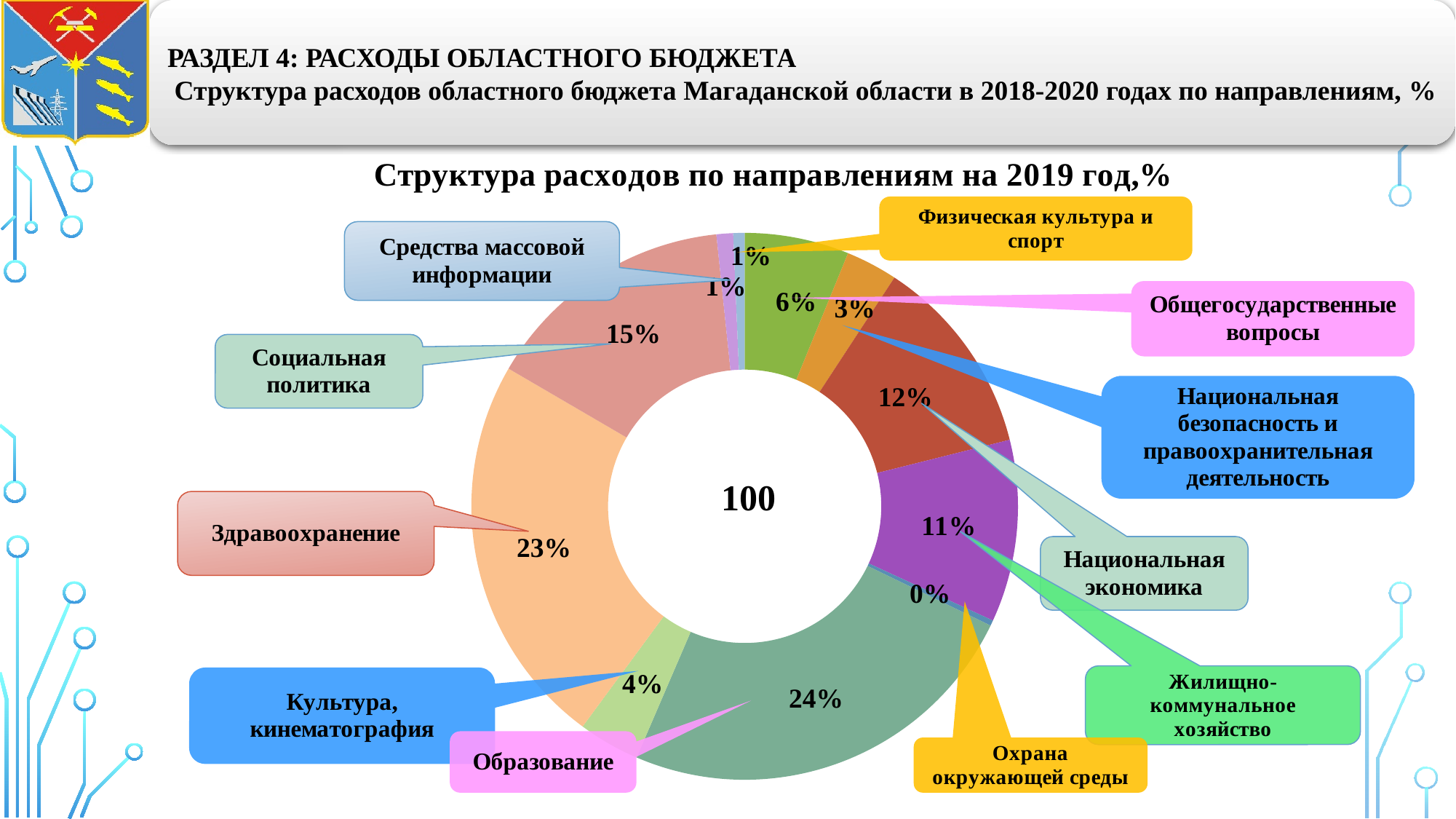
What share of expenditures goes to Охрана окружающей среды? 0% What share of expenditures goes to Образование? 24% What share of expenditures goes to Здравоохранение? 23% What is the title of the chart? Структура расходов по направлениям на 2019 год,% Which direction has the largest share of expenditures? Образование What is the difference in percentage points between Образование and Здравоохранение? 1 Which is larger: the share for Социальная политика or for Культура, кинематография? Социальная политика What type of chart is shown on the slide? Pie (doughnut) chart What share of expenditures goes to Социальная политика? 15% Which direction has the smallest share of expenditures? Охрана окружающей среды What number is shown in the centre of the doughnut chart? 100 What share of expenditures goes to Культура, кинематография? 4%